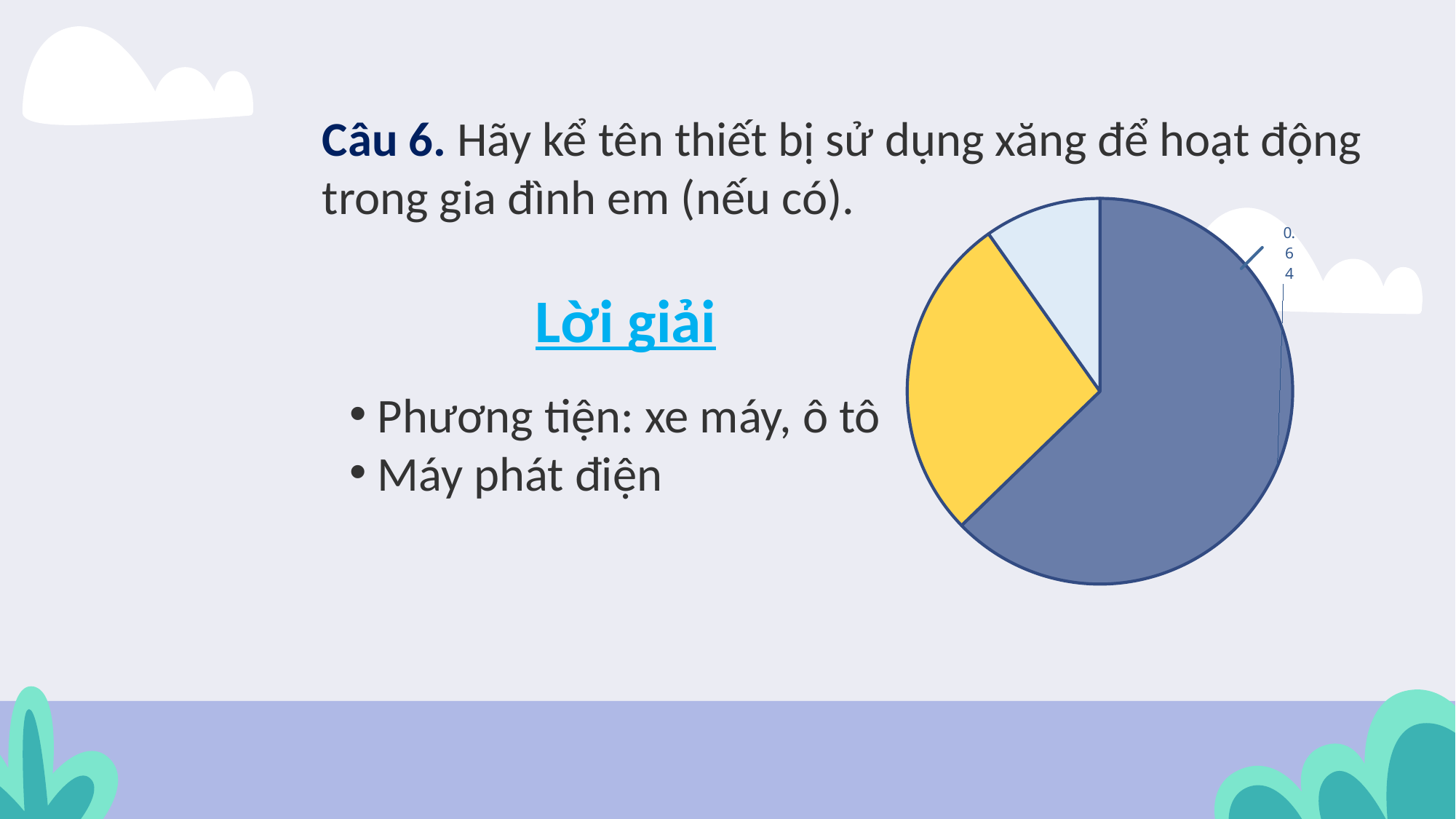
Which colour slice is the largest in the pie chart? dark blue What kind of chart is shown on the slide? pie chart Which slice of the pie chart is labelled with the value 0.64? the dark blue slice What value is printed as the data label on the pie chart? 0.64 Which colour slice is the smallest in the pie chart? light blue How many slices does the pie chart have? 3 Does the pie chart have a legend? No Which is larger in the pie chart, the yellow slice or the light blue slice? the yellow slice What share of the pie does the dark blue slice represent, according to its data label? 0.64 How many data labels are printed on the pie chart? 1 Does the dark blue slice take up more or less than half of the pie? more